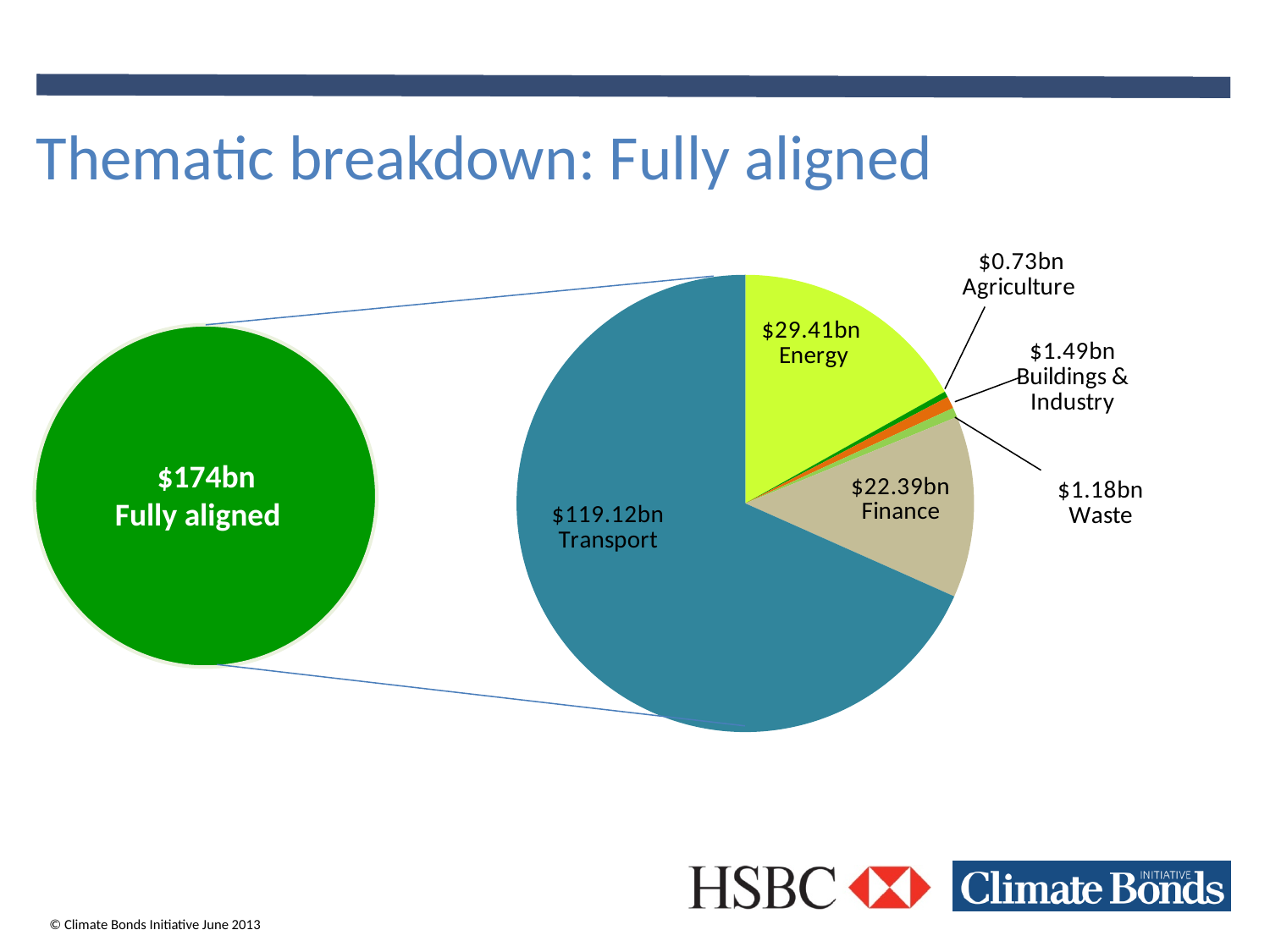
What kind of chart is used to show the thematic breakdown? Pie chart Which category has the smallest slice in the pie chart? Agriculture What is the value for Agriculture in the pie chart? $0.73bn Which category has the largest slice in the pie chart? Transport How many categories are shown in the pie chart? 6 What is the value for Transport in the pie chart? $119.12bn What is the difference between the Buildings & Industry and Waste values in the pie chart? $0.31bn What is the difference between the Energy and Finance values in the pie chart? $7.02bn What is the value for Finance in the pie chart? $22.39bn What is the value for Waste in the pie chart? $1.18bn Which is larger in the pie chart, Energy or Finance? Energy What is the value for Energy in the pie chart? $29.41bn